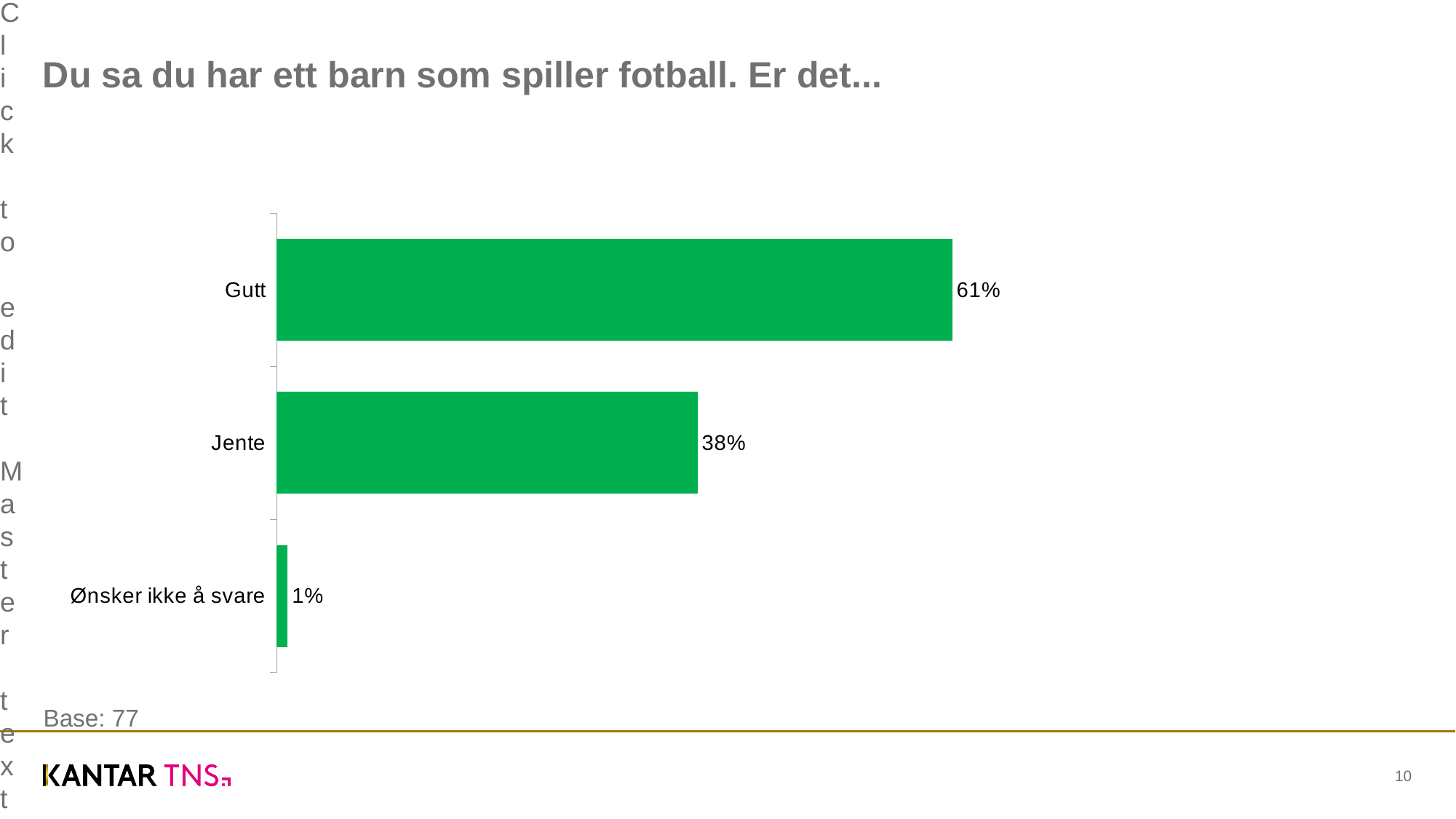
Which category has the lowest value? Ønsker ikke å svare What is the title of the chart on the slide? Du sa du har ett barn som spiller fotball. Er det... How many categories are shown in the chart? 3 What kind of chart is shown on the slide? Bar chart What is the value for Gutt? 61% What is the difference between the values for Jente and Ønsker ikke å svare? 37% What is the value for Ønsker ikke å svare? 1% Which category has the highest value? Gutt Which is larger, the value for Gutt or the value for Jente? Gutt What is the difference between the values for Gutt and Jente? 23% What is the value for Jente? 38% What base size is stated below the chart? 77